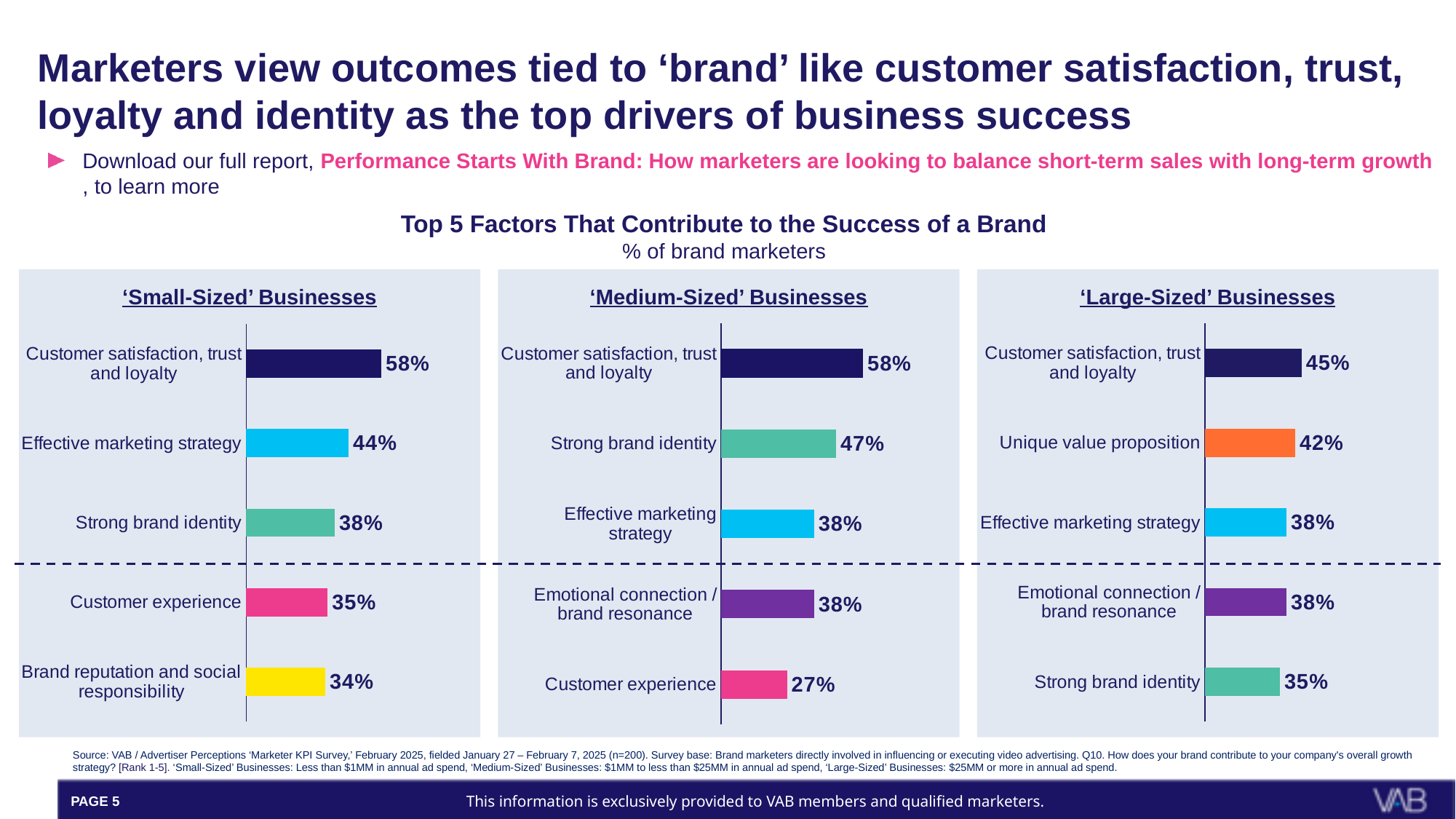
How many factors are shown in the 'Large-Sized' Businesses chart? 5 Which is larger: Customer experience in the 'Small-Sized' Businesses chart or Customer experience in the 'Medium-Sized' Businesses chart? 'Small-Sized' Businesses In the 'Medium-Sized' Businesses chart, which factor has the lowest value? Customer experience In the 'Small-Sized' Businesses chart, what percentage of brand marketers chose Effective marketing strategy? 44% In the 'Medium-Sized' Businesses chart, what is the value for Strong brand identity? 47% In the 'Small-Sized' Businesses chart, what is the difference between Customer satisfaction, trust and loyalty and Brand reputation and social responsibility? 24% What is the title shown above the three charts? Top 5 Factors That Contribute to the Success of a Brand In the 'Large-Sized' Businesses chart, what is the value for Unique value proposition? 42% What type of chart is used for the 'Small-Sized' Businesses data? Bar chart In the 'Medium-Sized' Businesses chart, what is the difference between Strong brand identity and Customer experience? 20% In the 'Large-Sized' Businesses chart, what is the value for Strong brand identity? 35% In the 'Large-Sized' Businesses chart, which factor has the highest value? Customer satisfaction, trust and loyalty